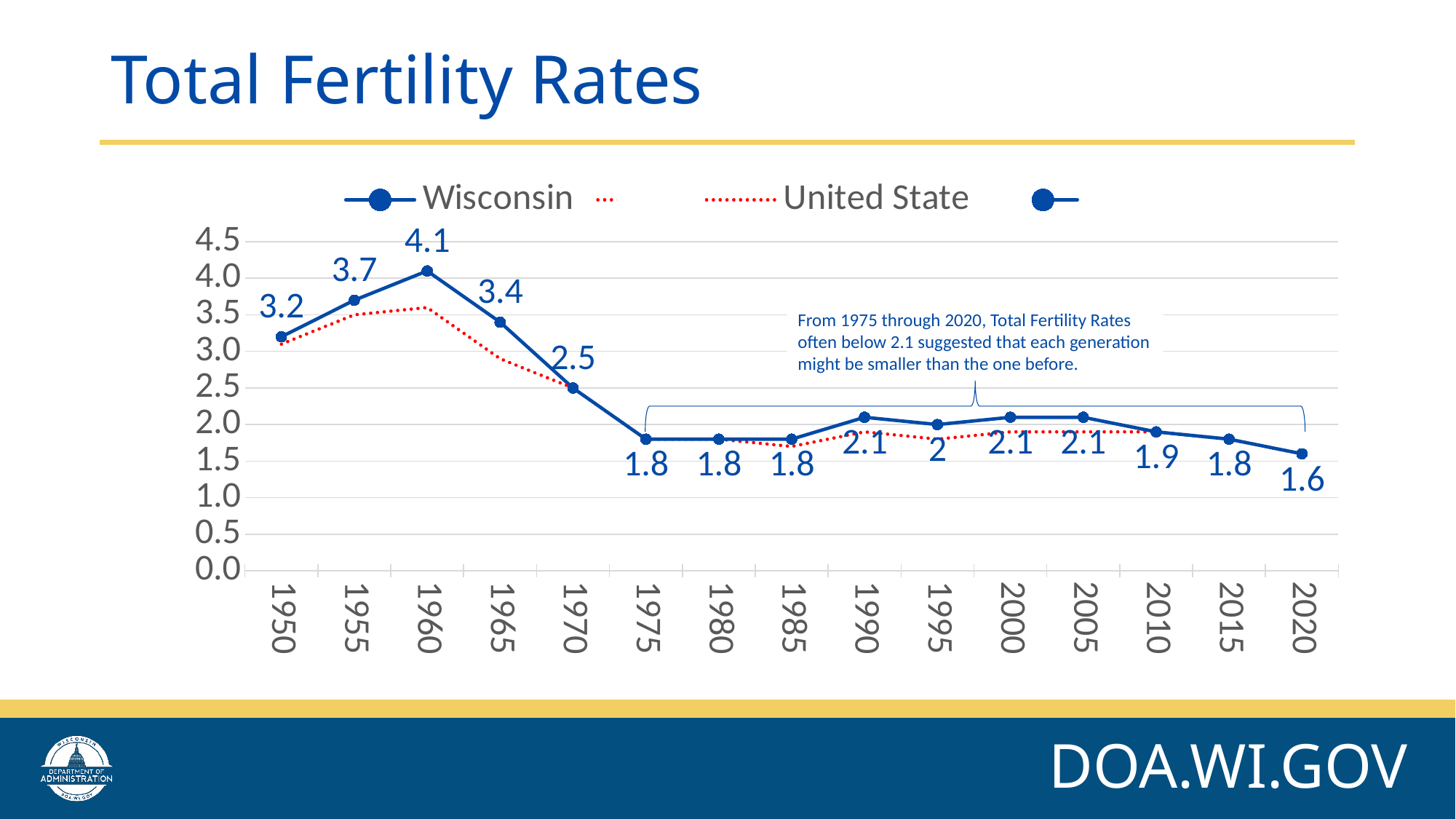
Does the Wisconsin series rise or fall between 1960 and 1975? Fall In which year does the Wisconsin series reach its lowest value? 2020 In which year does the Wisconsin series reach its highest value? 1960 What is the title of the slide? Total Fertility Rates What kind of chart is shown on the slide? Line chart How many years are shown on the x axis? 15 What is the difference between the Wisconsin values for 1960 and 2020? 2.5 Is the United States value for 1960 greater or less than 4.0? less What is the Wisconsin total fertility rate in 2020? 1.6 What is the Wisconsin total fertility rate in 1970? 2.5 Which year has the larger Wisconsin value, 1955 or 1965? 1955 What is the Wisconsin total fertility rate in 1960? 4.1